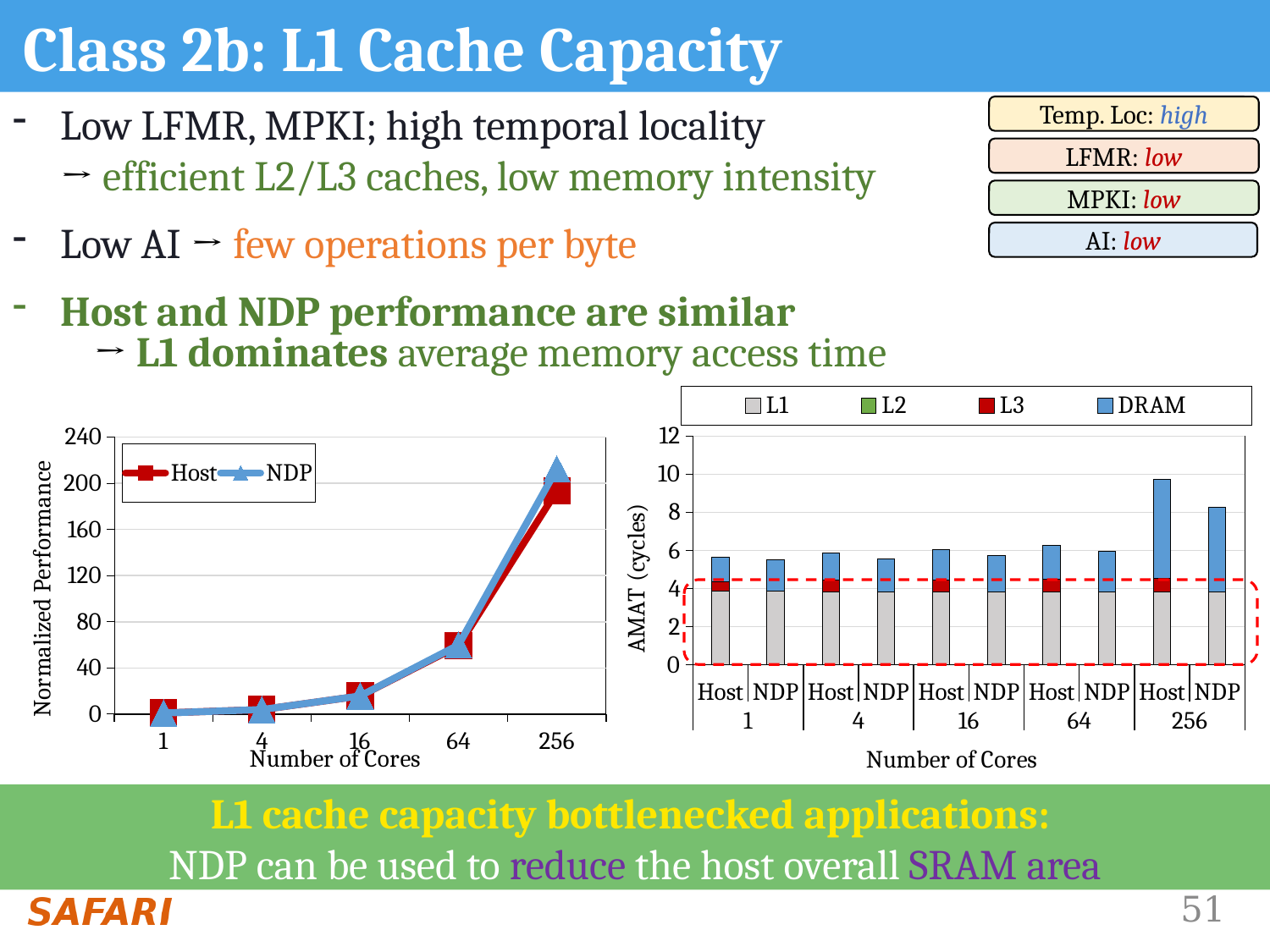
How many stacked bars are plotted in the right chart (AMAT)? 10 How many series does the legend of the left chart list? 2 How many core counts are shown on the x axis of the left chart? 5 What kind of chart is the right chart (AMAT vs Number of Cores)? bar chart In the left chart, is the Host value at 256 cores greater or less than 160? greater In the left chart, is the Host value at 64 cores greater or less than 80? less In the right chart (AMAT), which bar is the tallest? Host at 256 cores What kind of chart is the left chart (Normalized Performance vs Number of Cores)? line chart In the left chart, does Normalized Performance rise or fall as the number of cores increases? rise In the right chart (AMAT), which is larger at 256 cores, the Host bar or the NDP bar? Host In the right chart (AMAT), is the total for Host at 256 cores greater or less than 8? greater How many series does the legend of the right chart (AMAT) list? 4